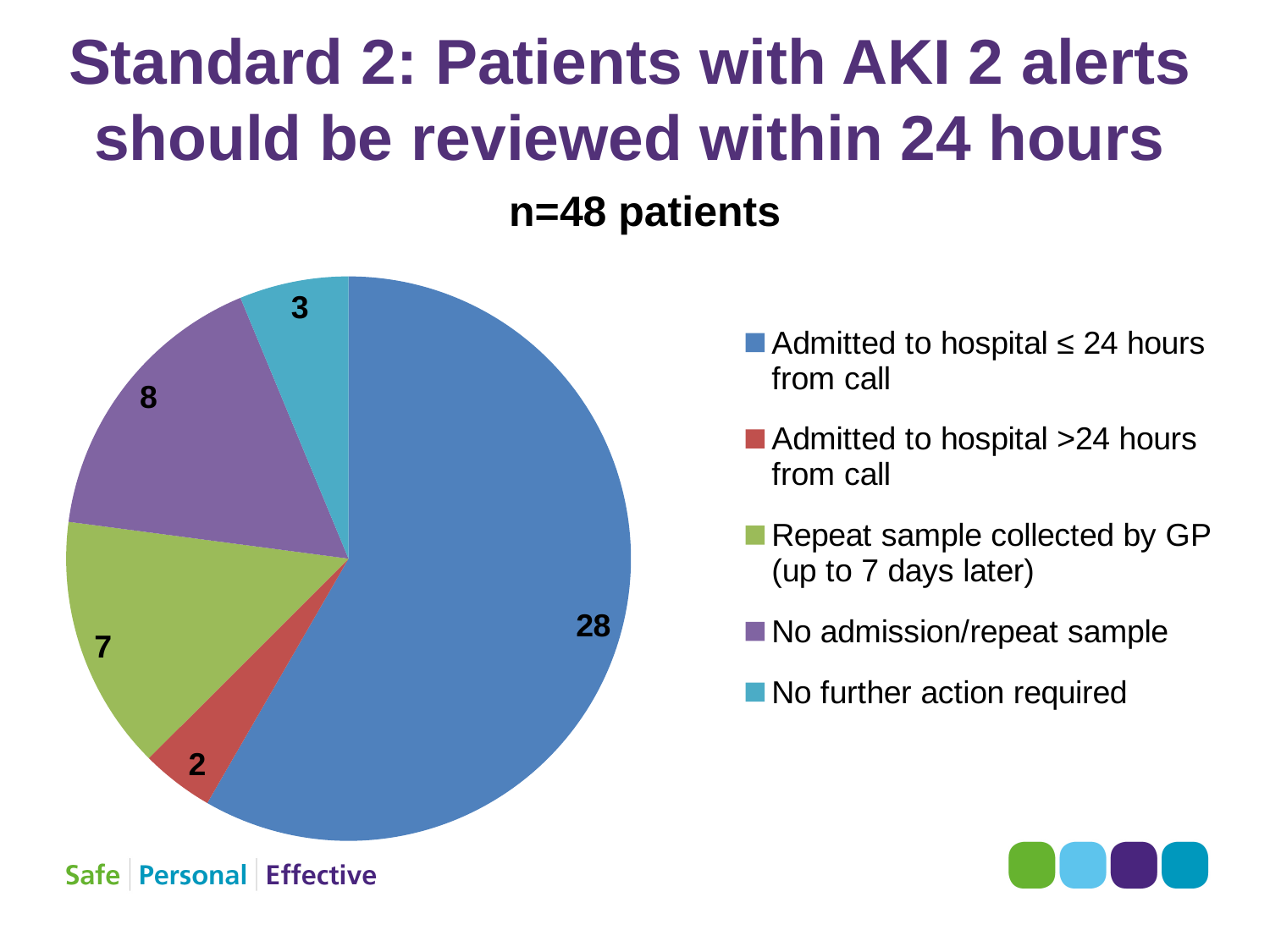
What colour is the slice for 'No further action required'? Teal (light blue) How many patients were admitted to hospital ≤ 24 hours from call? 28 Which category has the largest slice of the pie? Admitted to hospital ≤ 24 hours from call What share of the 48 patients were admitted to hospital ≤ 24 hours from call? 58.3% Which category has the smallest slice of the pie? Admitted to hospital >24 hours from call What type of chart is shown on the slide? Pie chart Which is larger: the number with no admission/repeat sample or the number with a repeat sample collected by GP? No admission/repeat sample How many patients had no admission/repeat sample? 8 How many patients had a repeat sample collected by GP (up to 7 days later)? 7 How many patients required no further action? 3 How many categories does the pie chart have? 5 What is the difference between the number admitted to hospital ≤ 24 hours from call and the number with no admission/repeat sample? 20